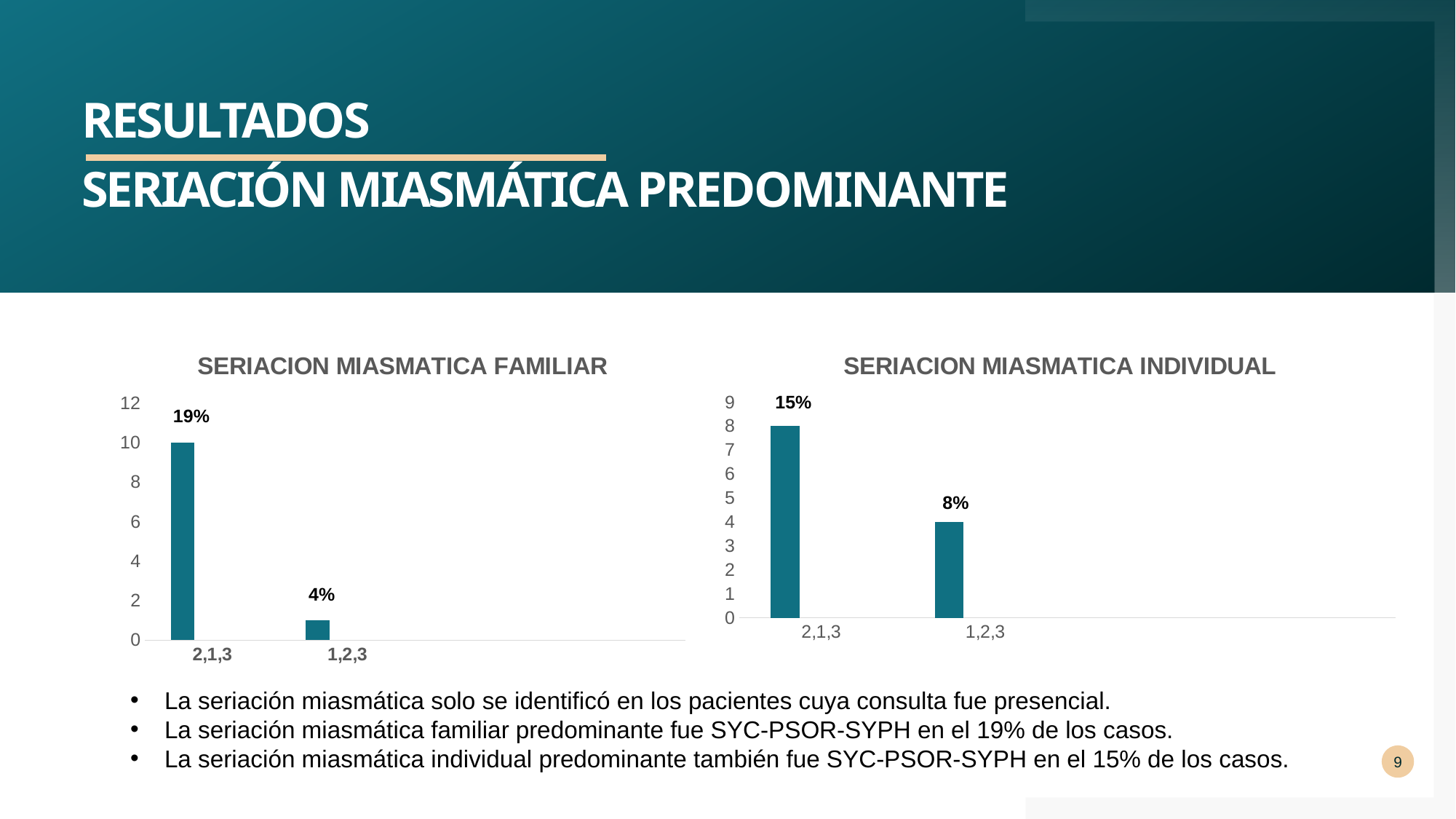
In the SERIACION MIASMATICA FAMILIAR chart, is the bar for 2,1,3 greater or less than 8 on the vertical axis? greater In the SERIACION MIASMATICA FAMILIAR chart, what is the data label on the bar for 2,1,3? 19% How many categories are shown in the SERIACION MIASMATICA INDIVIDUAL chart? 2 In the SERIACION MIASMATICA INDIVIDUAL chart, what is the difference between the percentage labels for 2,1,3 and 1,2,3? 7% In the SERIACION MIASMATICA FAMILIAR chart, which category has the highest bar? 2,1,3 In the SERIACION MIASMATICA INDIVIDUAL chart, what is the data label on the bar for 1,2,3? 8% What type of chart is the SERIACION MIASMATICA FAMILIAR chart? Bar chart In the SERIACION MIASMATICA INDIVIDUAL chart, is the bar for 1,2,3 greater or less than 6 on the vertical axis? less In the SERIACION MIASMATICA INDIVIDUAL chart, which category has the lowest bar? 1,2,3 In the SERIACION MIASMATICA FAMILIAR chart, what is the data label on the bar for 1,2,3? 4% In the SERIACION MIASMATICA INDIVIDUAL chart, what is the data label on the bar for 2,1,3? 15% In the SERIACION MIASMATICA FAMILIAR chart, what is the difference between the percentage labels for 2,1,3 and 1,2,3? 15%